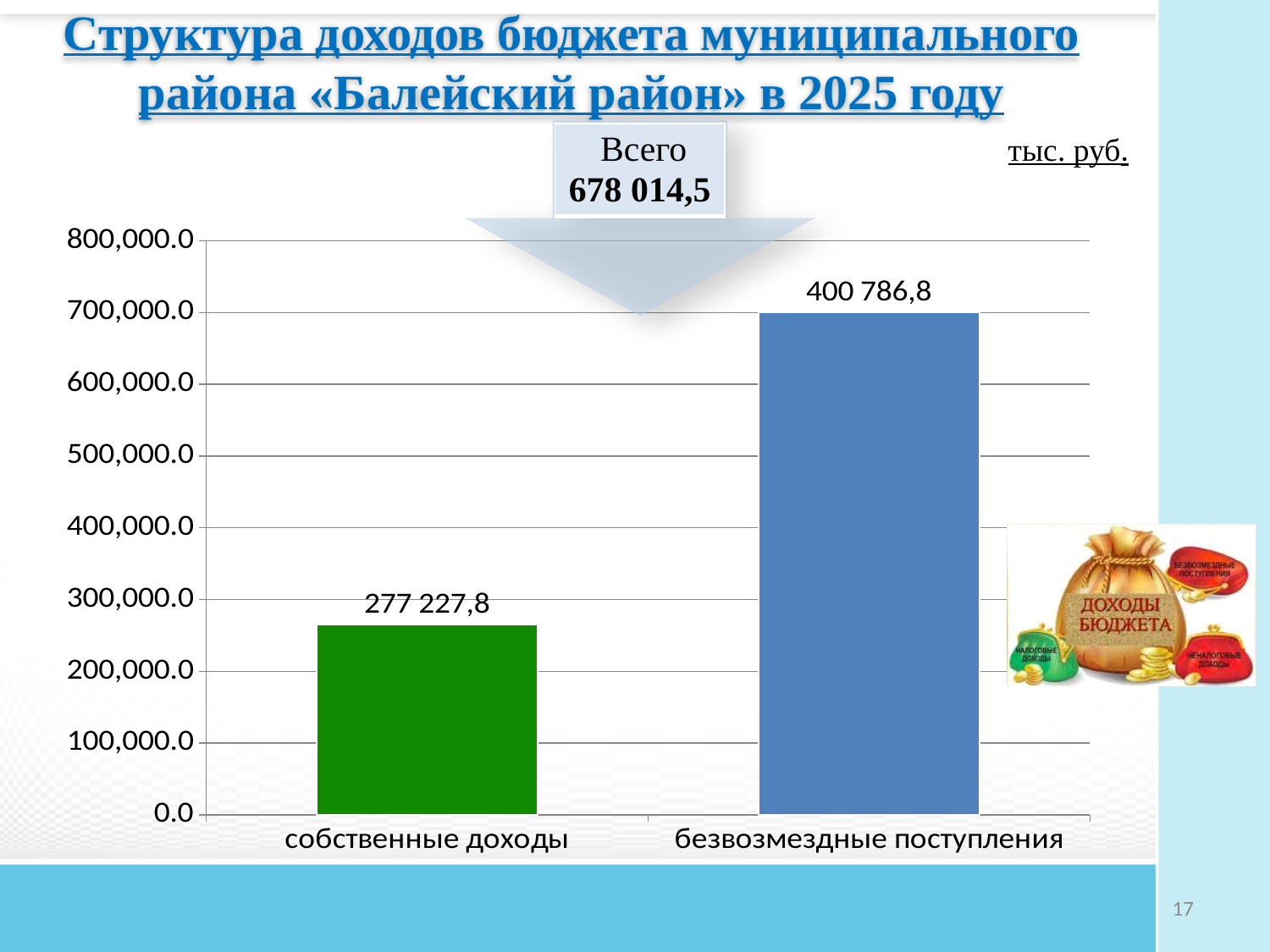
Is the value for собственные доходы greater or less than 200,000.0? greater What kind of chart is shown on the slide? bar chart What is the value for безвозмездные поступления? 400 786,8 What is the value for собственные доходы? 277 227,8 What colour is the bar for собственные доходы? green Which is larger: собственные доходы or безвозмездные поступления? безвозмездные поступления Is the value for собственные доходы greater or less than 300,000.0? less Which category has the lowest value? собственные доходы Which category has the highest value? безвозмездные поступления What total (Всего) is shown above the chart? 678 014,5 What is the difference between безвозмездные поступления and собственные доходы? 123 559,0 How many categories are shown on the chart? 2